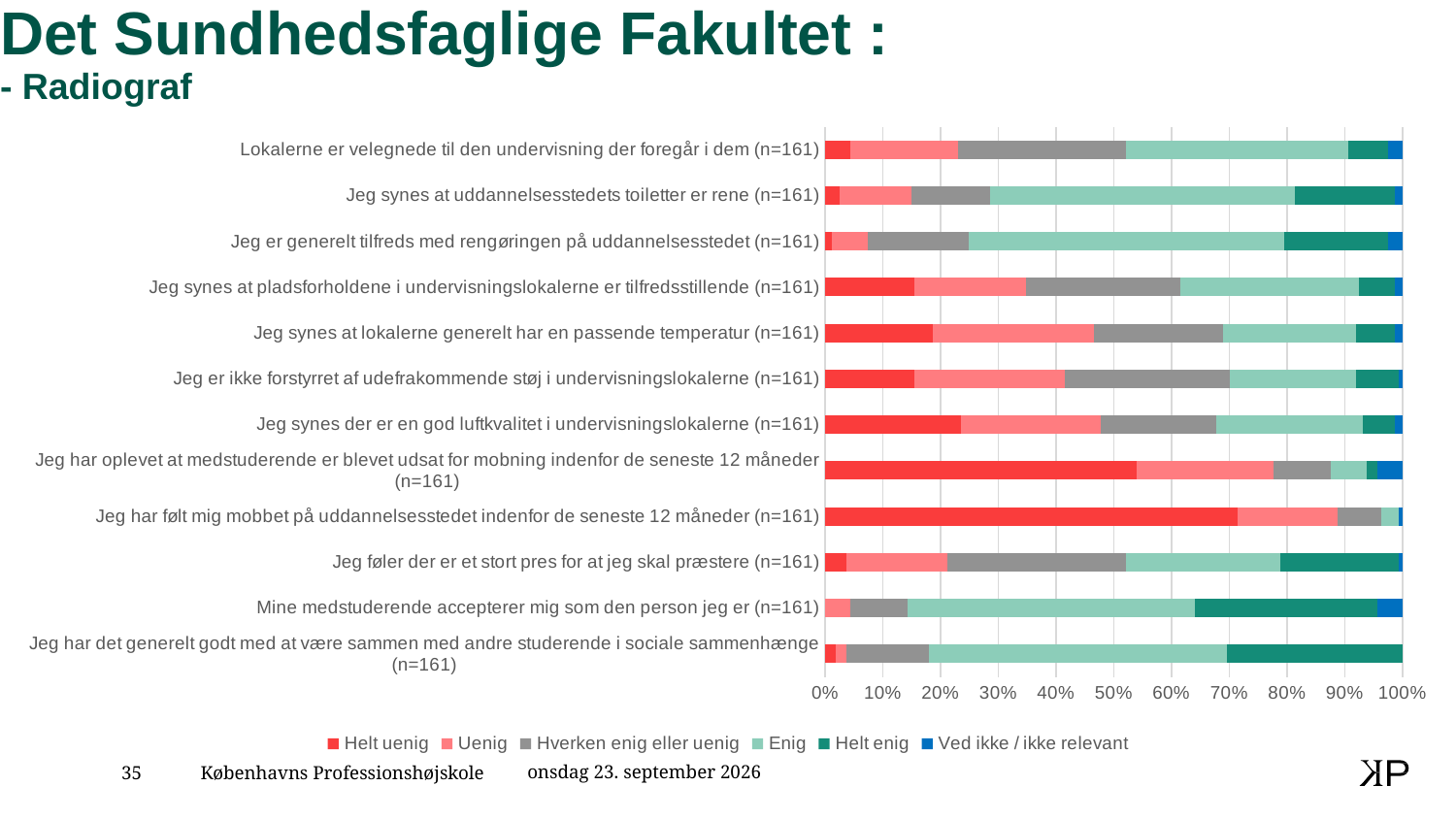
Is the 'Enig' share for 'Mine medstuderende accepterer mig som den person jeg er' greater or less than 40%? greater Is the 'Helt uenig' share for 'Jeg synes at uddannelsesstedets toiletter er rene' greater or less than 10%? less Is the 'Helt uenig' share for 'Jeg har følt mig mobbet på uddannelsesstedet indenfor de seneste 12 måneder' greater or less than 60%? greater What kind of chart is shown on the slide? Stacked bar chart Which response category is shown in dark red in the legend? Helt uenig Which statement has the largest 'Helt uenig' share? Jeg har følt mig mobbet på uddannelsesstedet indenfor de seneste 12 måneder (n=161) What is the sample size (n) shown for each statement in the chart? 161 Which has the larger 'Helt uenig' share: 'Jeg synes der er en god luftkvalitet i undervisningslokalerne' or 'Jeg synes at uddannelsesstedets toiletter er rene'? Jeg synes der er en god luftkvalitet i undervisningslokalerne How many series does the legend list? 6 How many statements (categories) are plotted in the chart? 12